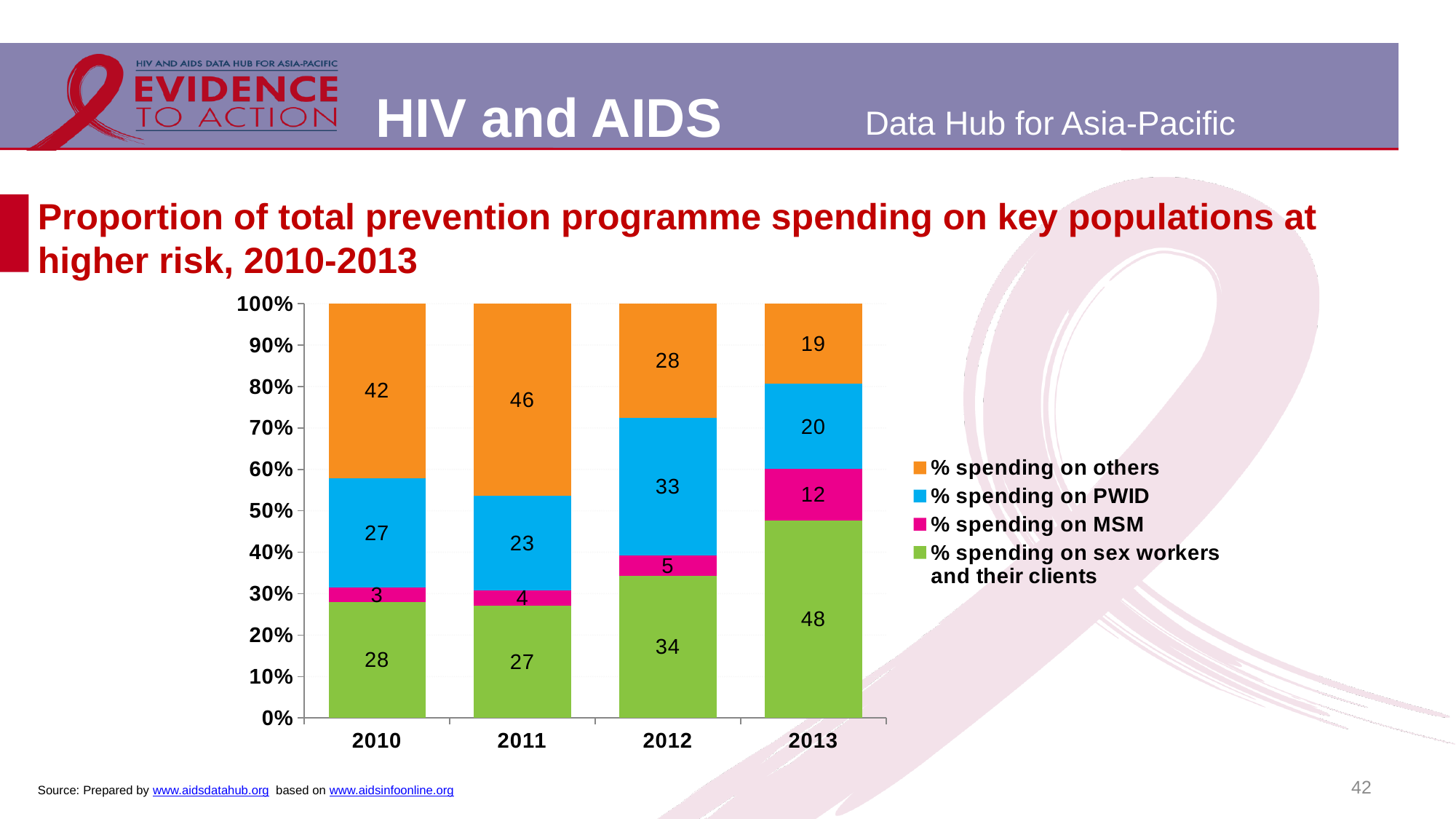
In which year is the % spending on MSM lowest? 2010 Which is larger: the % spending on PWID in 2010 or in 2013? 2010 How many years are shown on the x axis? 4 What is the % spending on sex workers and their clients in 2013? 48 In which year is the % spending on others highest? 2011 What kind of chart is shown on the slide? Stacked bar chart What is the % spending on MSM in 2010? 3 What is the % spending on others in 2011? 46 How many series does the legend list? 4 Does the % spending on MSM rise or fall from 2010 to 2013? Rise What is the % spending on PWID in 2012? 33 What is the difference between the % spending on others in 2011 and in 2013? 27